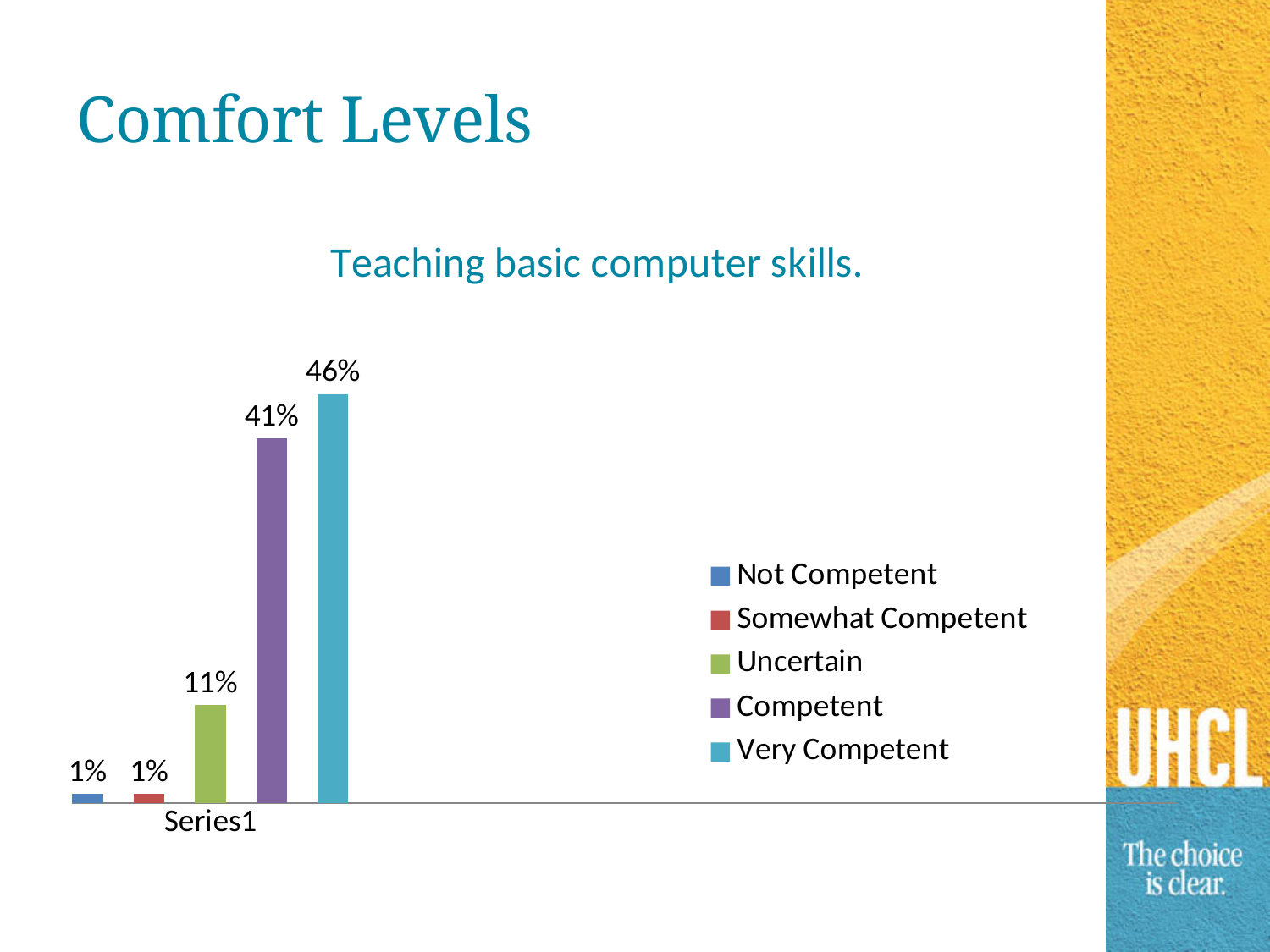
What is the value for Not Competent? 1% What is the title of the chart? Teaching basic computer skills. How many series does the legend list? 5 What is the difference between the Very Competent and Competent values? 5% What is the value for Uncertain? 11% What is the value for Very Competent? 46% What kind of chart is shown on the slide? Bar chart Which is larger, the value for Uncertain or the value for Somewhat Competent? Uncertain What colour is the bar for Competent? Purple What is the value for Competent? 41% Which series has the highest value? Very Competent What is the difference between the Competent and Uncertain values? 30%